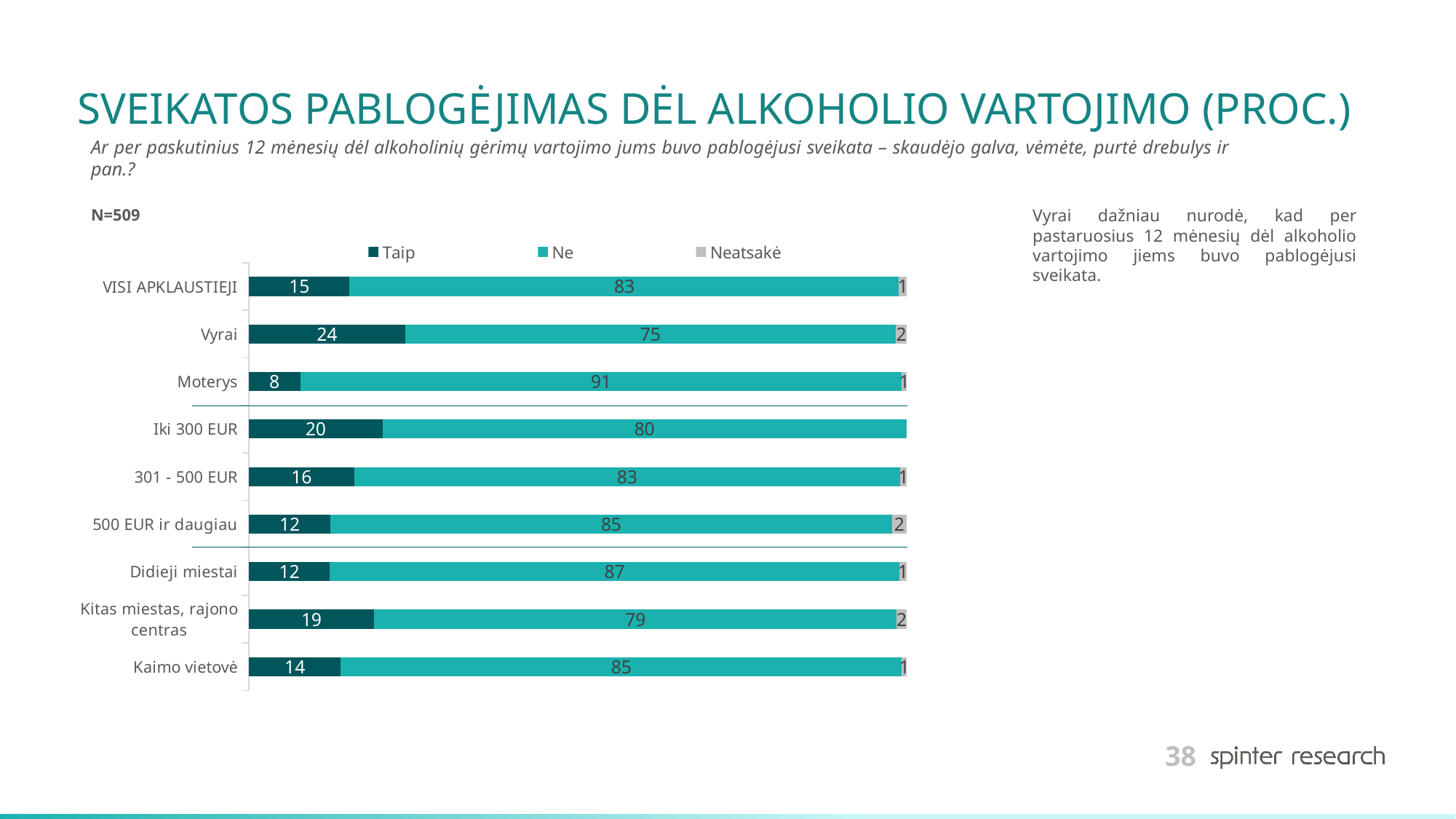
What is the "Ne" value for Moterys? 91 How many categories are shown on the chart? 9 What is the "Taip" value for Vyrai? 24 What is the total of the stacked bar for Iki 300 EUR? 100 Which category has the highest "Taip" value? Vyrai Which has a larger "Ne" value, Didieji miestai or Kaimo vietovė? Didieji miestai Which category has the lowest "Taip" value? Moterys What is the "Taip" value for Kitas miestas, rajono centras? 19 What kind of chart is shown on the slide? Stacked bar chart What is the "Neatsakė" value for 500 EUR ir daugiau? 2 How many series does the legend list? 3 What is the difference between the "Taip" values for Vyrai and Moterys? 16